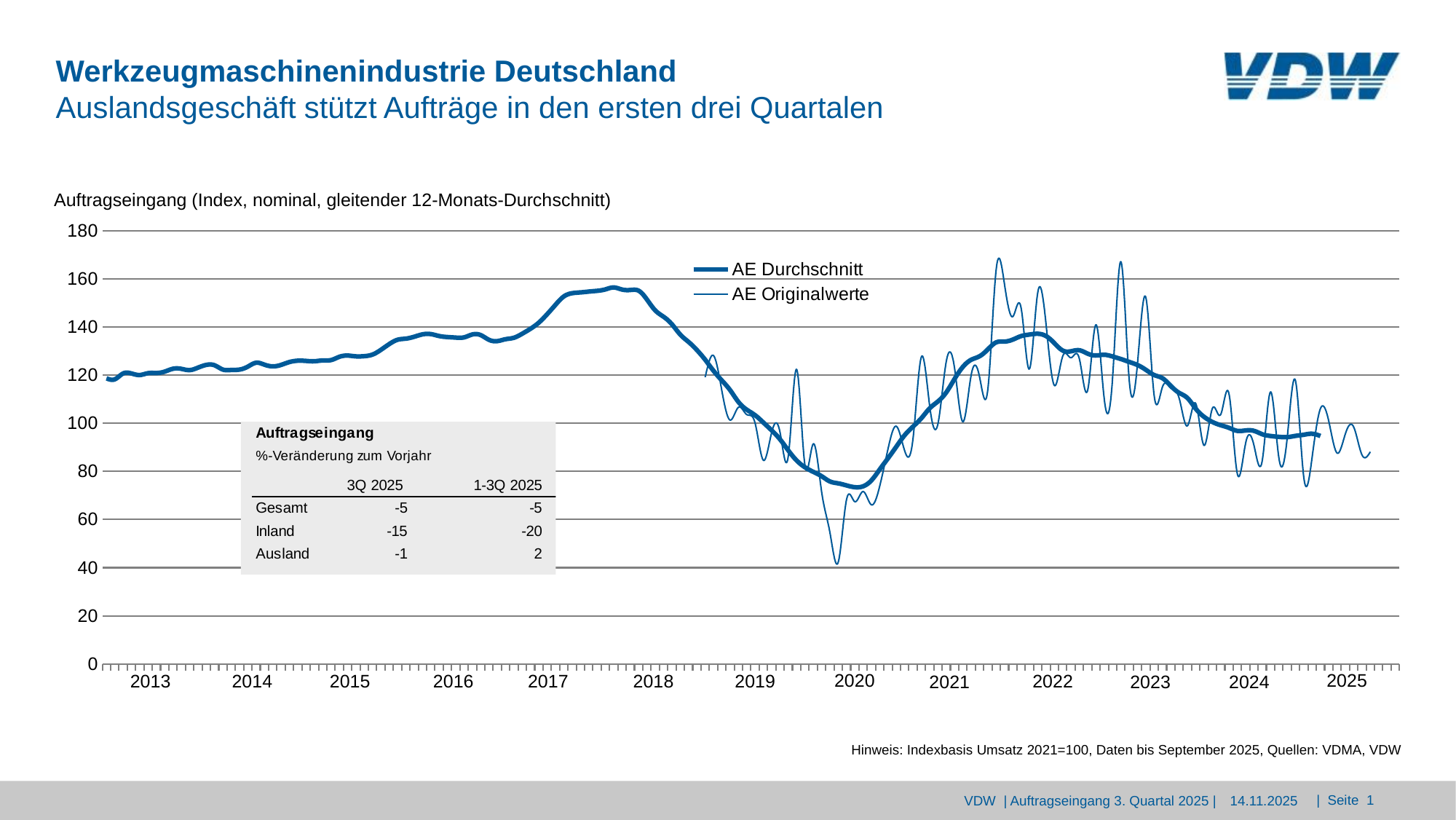
In which year does the AE Durchschnitt line reach its highest level? 2018 What is the highest value shown on the chart's vertical axis? 180 What are the two series named in the chart legend? AE Durchschnitt and AE Originalwerte Does the AE Durchschnitt line rise or fall between 2022 and 2024? fall How many series does the chart legend list? 2 How many year labels are shown along the x axis of the chart? 13 Which is higher, the AE Durchschnitt value at the start of 2018 or at the start of 2020? start of 2018 Does the AE Durchschnitt line rise or fall between 2013 and 2017? rise Is the AE Durchschnitt value at the start of 2020 greater or less than 100? less Is the peak value of the AE Durchschnitt line in 2017 greater or less than 140? greater What kind of chart is shown on the slide? line chart